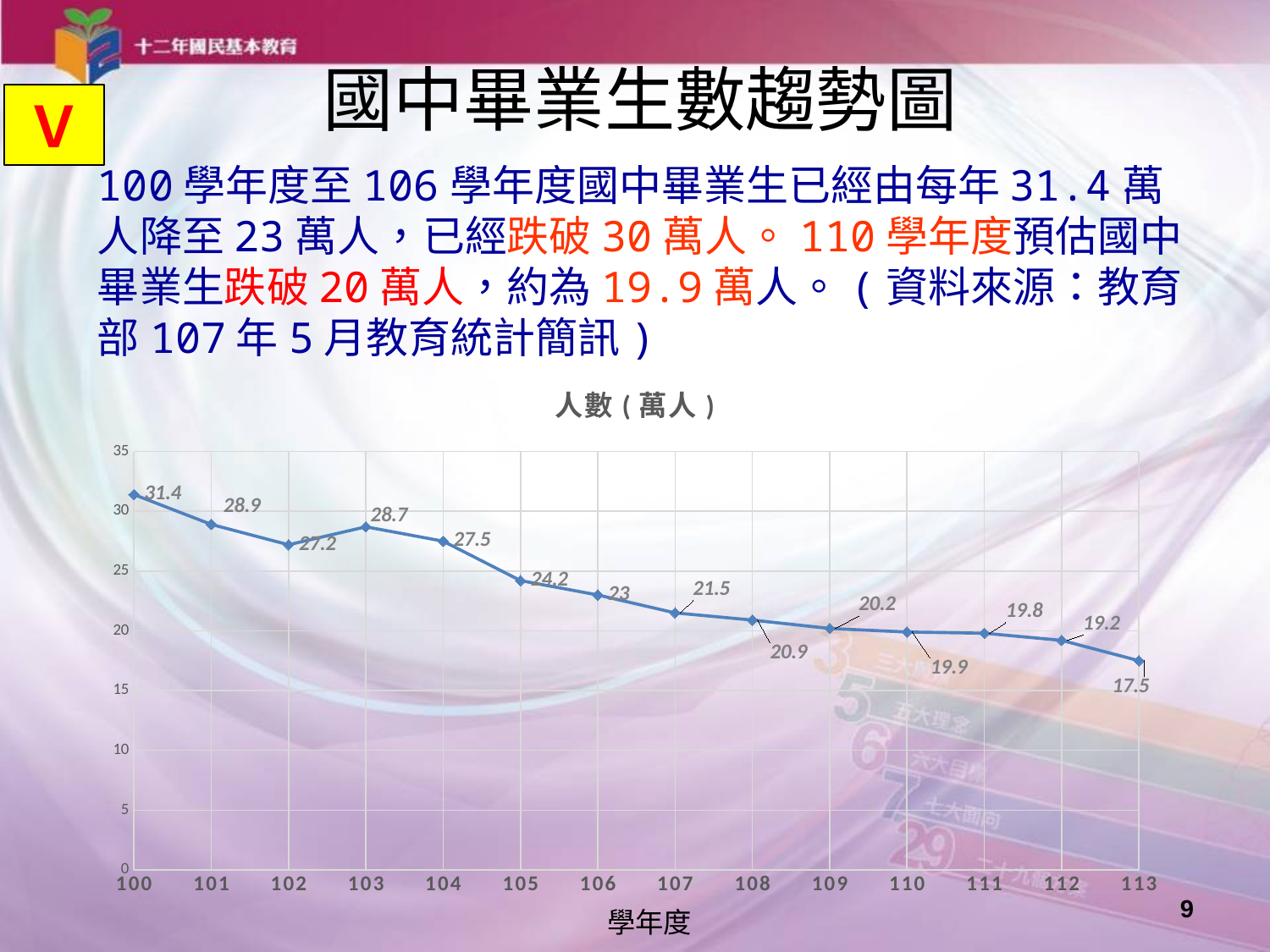
Which 學年度 has the lowest value in the chart? 113 What is the title of the chart? 人數（萬人） Which 學年度 has the highest value in the chart? 100 What type of chart is shown on the slide? line chart What is the difference between the values for 學年度 100 and 學年度 106? 8.4 What is the value for 學年度 110 in the chart? 19.9 How many 學年度 data points are plotted in the chart? 14 What is the value for 學年度 113 in the chart? 17.5 Which is larger, the value for 學年度 103 or the value for 學年度 102? 103 What is the value for 學年度 100 in the chart? 31.4 Do the values generally rise or fall from 學年度 100 to 學年度 113? fall What is the value for 學年度 106 in the chart? 23